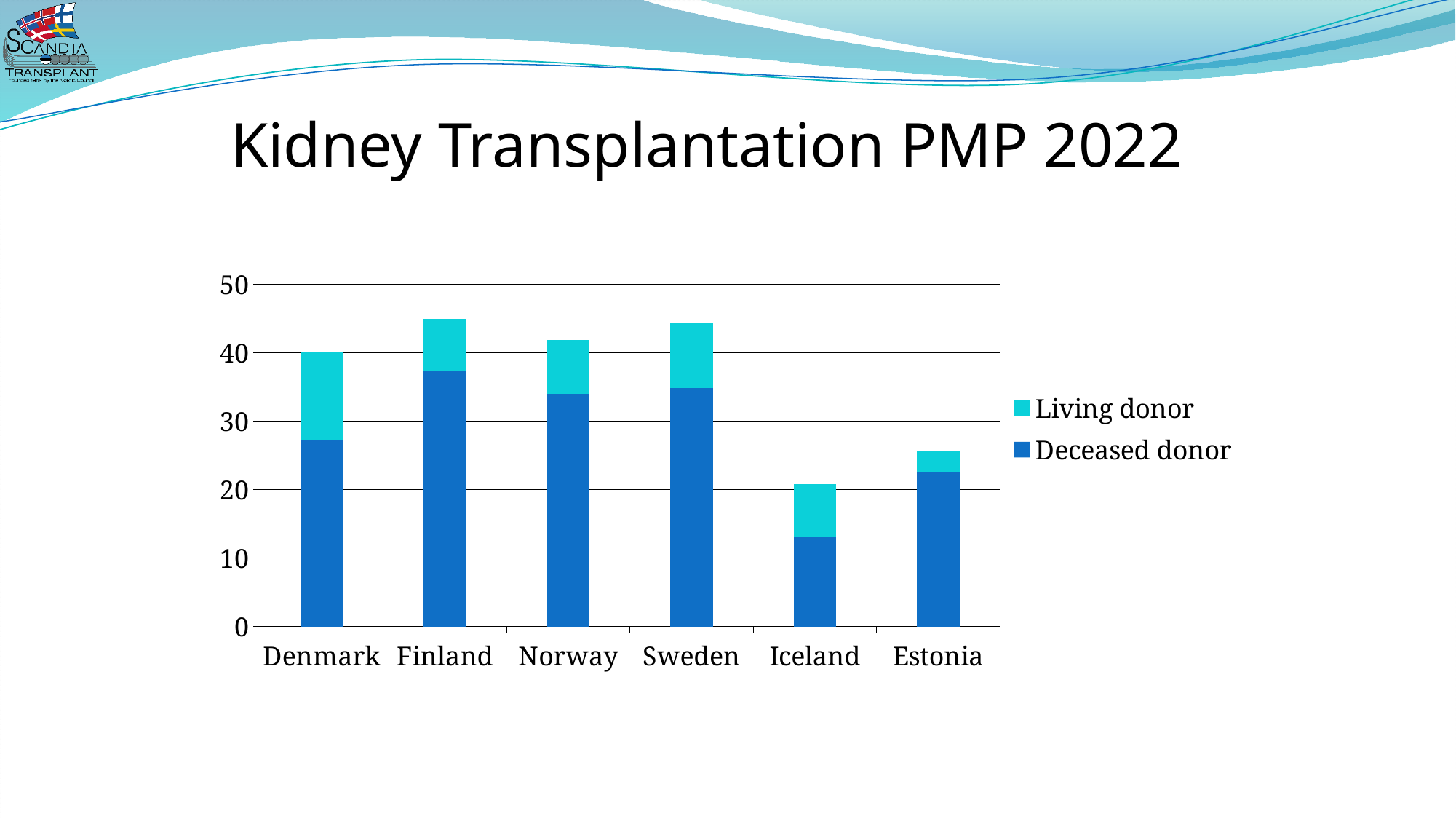
Is the Deceased donor value for Finland greater or less than 30? greater Is the total bar height for Norway greater or less than 40? greater Is the Deceased donor value for Denmark greater or less than 30? less Which series is shown in the darker blue colour in the chart? Deceased donor Which country has the larger total bar, Denmark or Estonia? Denmark Which country has the lowest total kidney transplantation PMP in the chart? Iceland Which country has the largest Living donor segment in the chart? Denmark Which country has the smallest Deceased donor segment in the chart? Iceland What kind of chart is shown on the slide? Stacked bar chart How many series does the chart legend list? 2 How many countries are shown on the x axis of the chart? 6 Which country has the smallest Living donor segment in the chart? Estonia